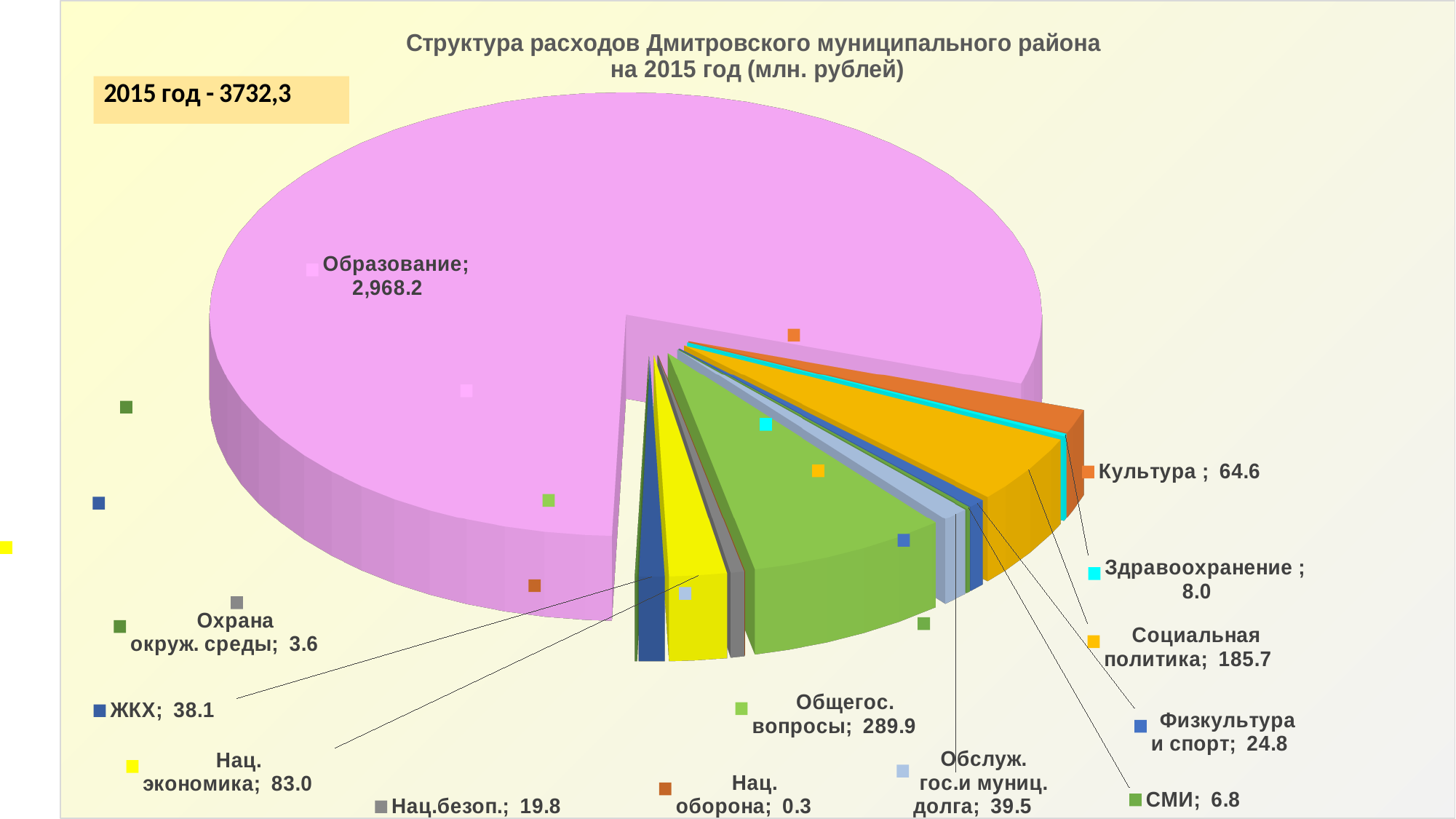
What is the difference between Общегос. вопросы and Социальная политика? 104.2 What is the difference between ЖКХ and Обслуж. гос.и муниц. долга? 1.4 What is the value for Образование? 2,968.2 What is the value for Социальная политика? 185.7 What is the value for Нац. оборона? 0.3 Which category has the largest slice of the pie? Образование How many categories are shown in the pie chart? 13 What is the value for Общегос. вопросы? 289.9 What type of chart is shown on the slide? Pie chart Which is larger, Культура or Нац. экономика? Нац. экономика Which category has the smallest value? Нац. оборона What total for 2015 is shown in the box at the top left of the slide? 3732,3